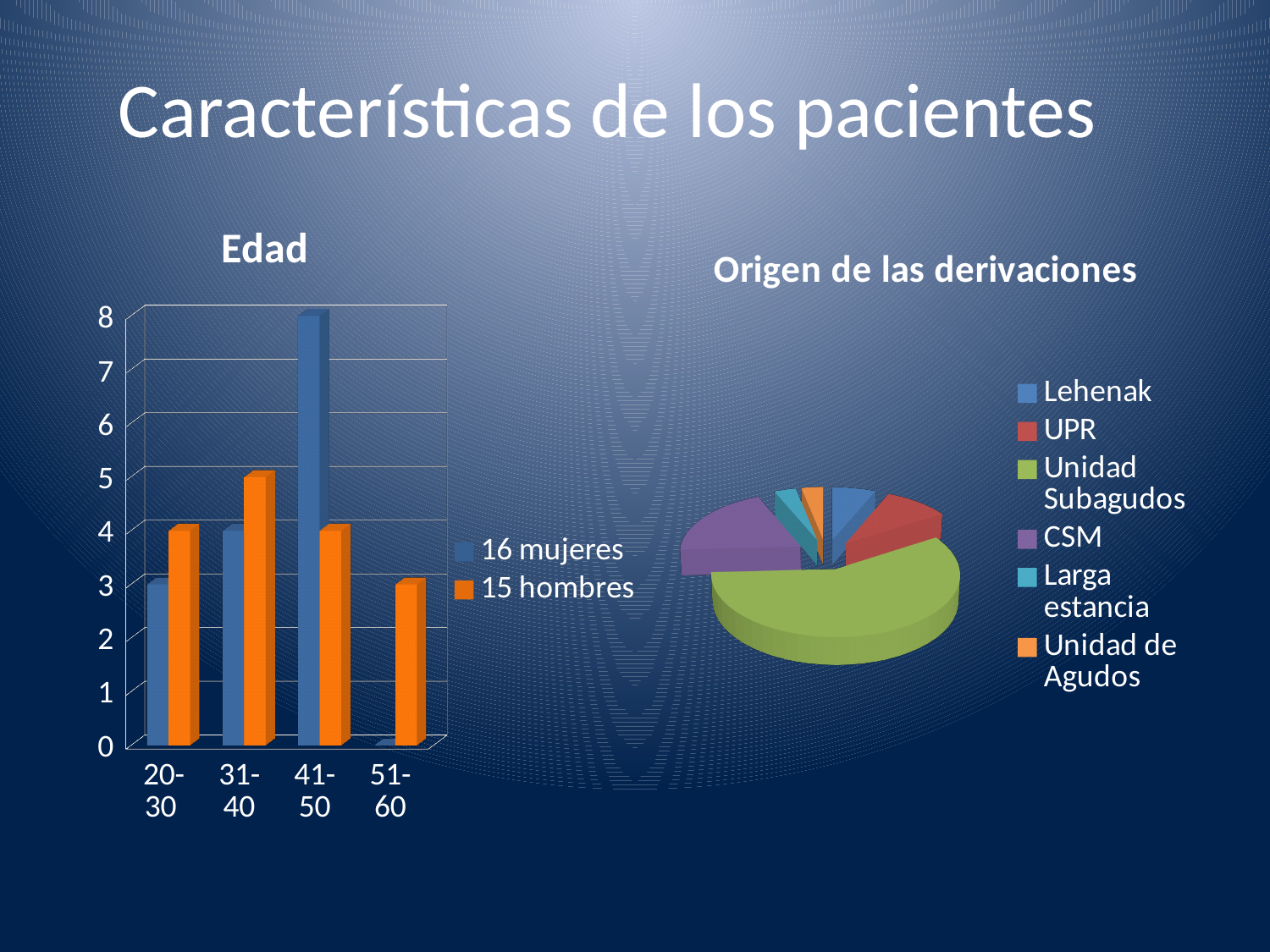
In the "Edad" chart, for the 31-40 group, which series has the larger value, "16 mujeres" or "15 hombres"? 15 hombres In the "Edad" chart, is the "16 mujeres" value for 41-50 greater or less than 6? greater In the "Origen de las derivaciones" chart, which category has the largest slice? Unidad Subagudos In the "Edad" chart, how many age groups are shown on the x axis? 4 What kind of chart is the "Edad" chart on the left? bar chart In the "Edad" chart, how many series does the legend list? 2 In the "Edad" chart, what are the two legend entries? 16 mujeres and 15 hombres In the "Edad" chart, which age group has the highest bar for "16 mujeres"? 41-50 What kind of chart is the "Origen de las derivaciones" chart on the right? pie chart In the "Edad" chart, for the 41-50 group, which series has the larger value, "16 mujeres" or "15 hombres"? 16 mujeres In the "Edad" chart, is the "15 hombres" value for 51-60 greater or less than 4? less In the "Origen de las derivaciones" chart, how many categories does the legend list? 6